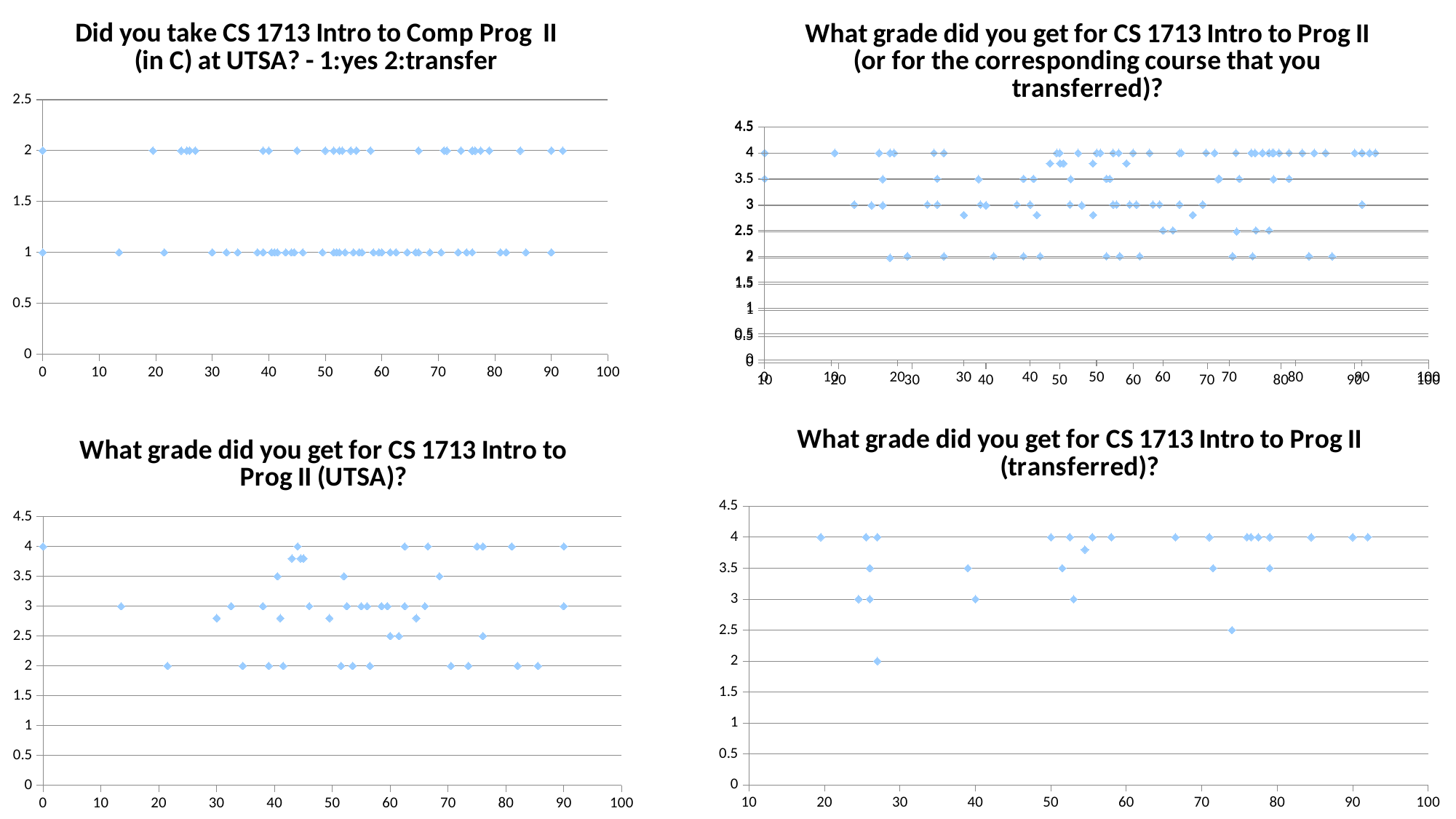
What is the title of the top-left chart? Did you take CS 1713 Intro to Comp Prog II (in C) at UTSA? - 1:yes 2:transfer In the bottom-right chart titled "What grade did you get for CS 1713 Intro to Prog II (transferred)?", is the lowest plotted grade greater or less than 2.5? less In the bottom-left chart titled "What grade did you get for CS 1713 Intro to Prog II (UTSA)?", what is the highest grade value plotted? 4 In the bottom-right chart titled "What grade did you get for CS 1713 Intro to Prog II (transferred)?", what is the highest grade value plotted? 4 In the top-left chart, what is the highest y-value at which points are plotted? 2 What kind of chart is the bottom-left chart titled "What grade did you get for CS 1713 Intro to Prog II (UTSA)?"? scatter chart How many charts are shown on the slide? 4 In the top-left chart, how many distinct y-values do the plotted points take? 2 In the top-left chart, what is the lowest y-value at which points are plotted? 1 In the top-left chart, is any plotted point greater than 2? no In the bottom-right chart titled "What grade did you get for CS 1713 Intro to Prog II (transferred)?", what is the lowest grade value plotted? 2 In the bottom-left chart titled "What grade did you get for CS 1713 Intro to Prog II (UTSA)?", what is the lowest grade value plotted? 2